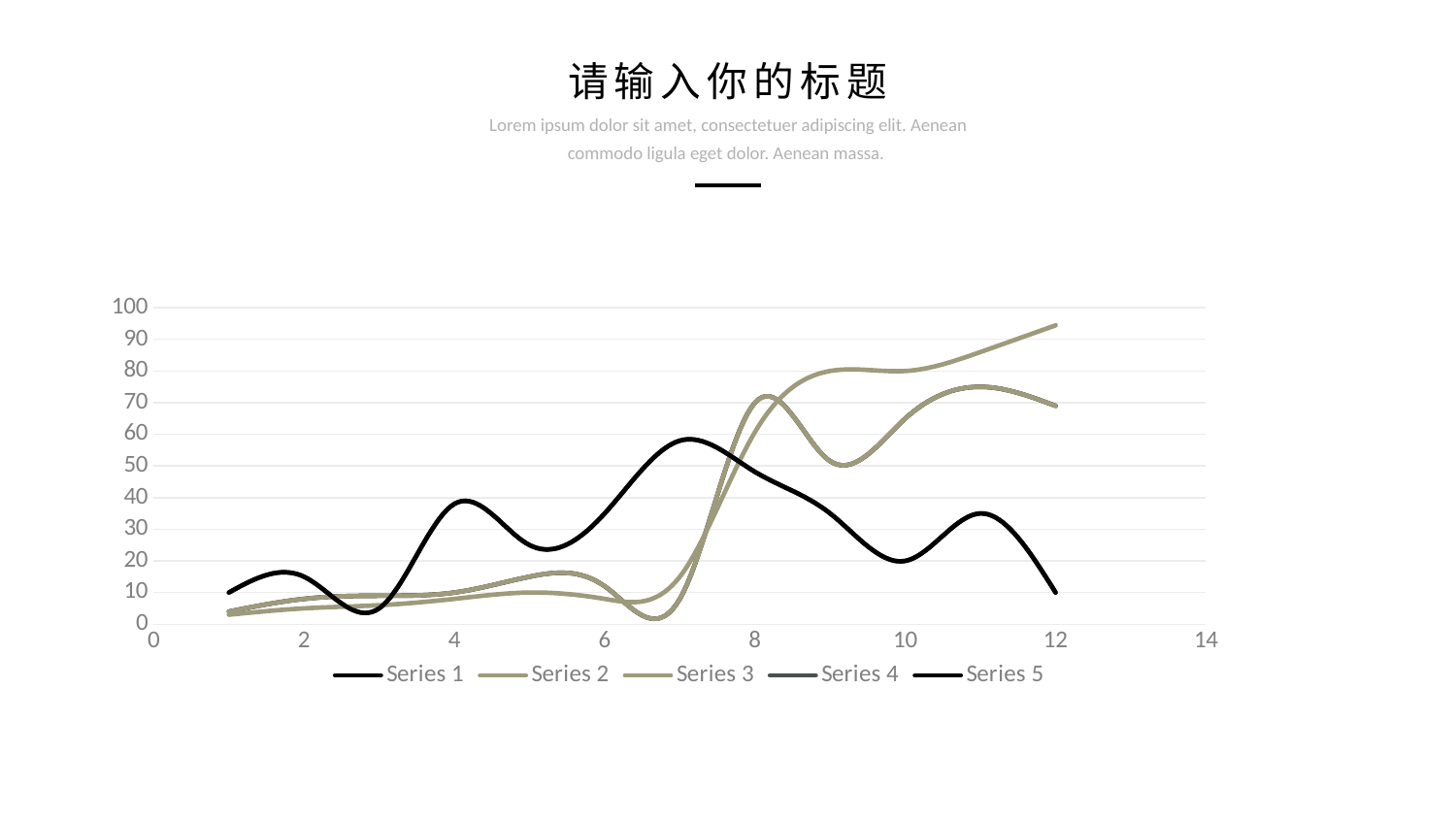
Is the value of the black line at x = 7 greater or less than 50? greater How many series does the legend list? 5 Is the highest point reached by any line on the chart greater or less than 90? greater What is the highest value shown on the vertical axis? 100 Does the line that reaches the highest value on the chart generally rise or fall from x = 1 to x = 12? rise What is the title of the slide above the chart? 请输入你的标题 Is the value of the black line at x = 10 greater or less than 30? less What kind of chart is shown on the slide? line chart At x = 12, is the black line higher or lower than the other lines? lower